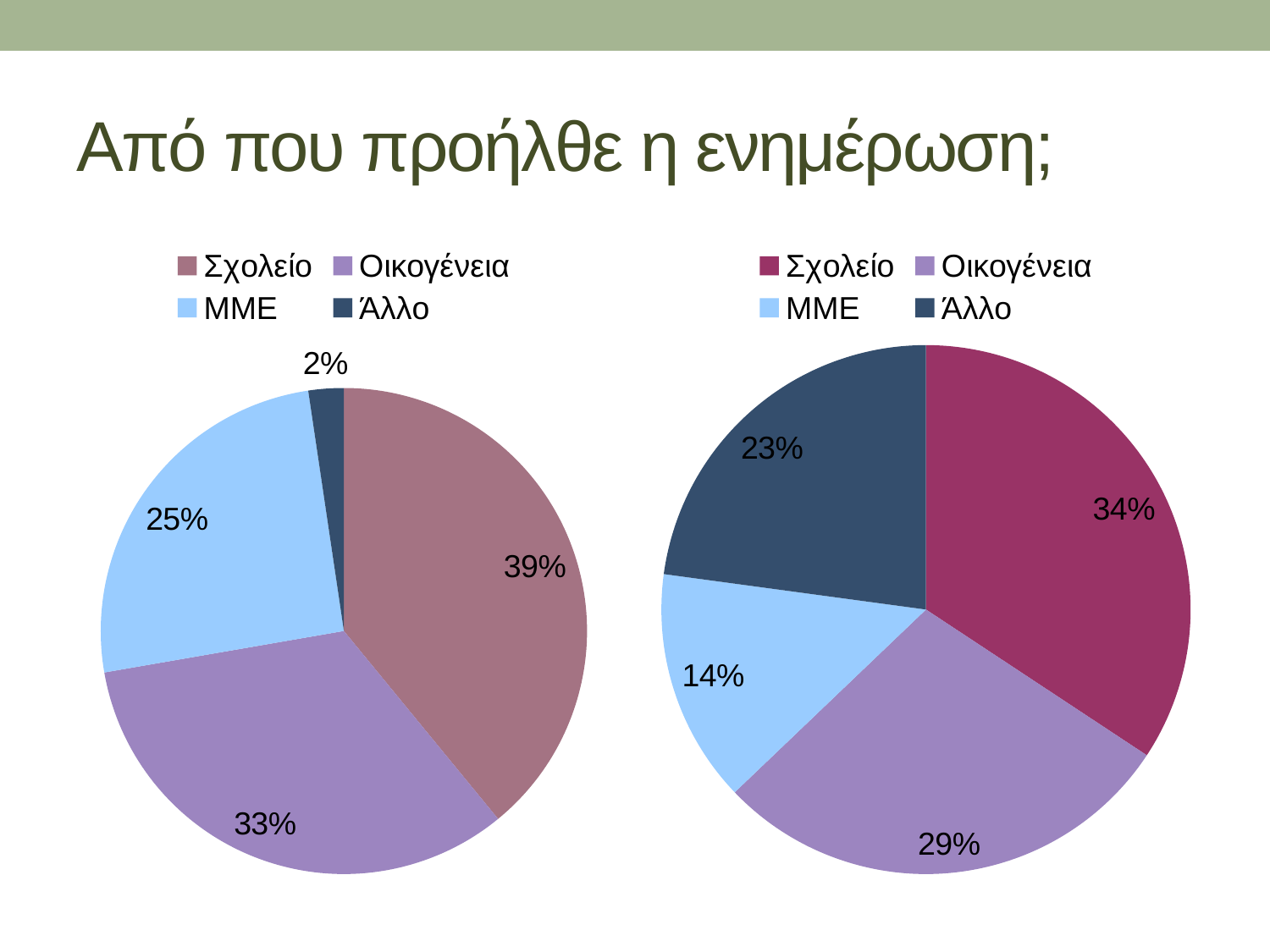
In the left pie chart, which category has the smallest slice? Άλλο In the right pie chart, what share does Άλλο have? 23% In the right pie chart, what is the value for Οικογένεια? 29% In the right pie chart, what is the difference between the Άλλο and ΜΜΕ shares? 9% In the left pie chart, what is the value for ΜΜΕ? 25% In the left pie chart, what is the difference between the Σχολείο and Οικογένεια shares? 6% In the left pie chart, what share does Σχολείο have? 39% In the left pie chart, which is larger, ΜΜΕ or Οικογένεια? Οικογένεια In the right pie chart, which category has the largest slice? Σχολείο How many slices does the right pie chart have? 4 In the right pie chart, which category has the smallest slice? ΜΜΕ What type of chart is shown on the left of the slide? Pie chart